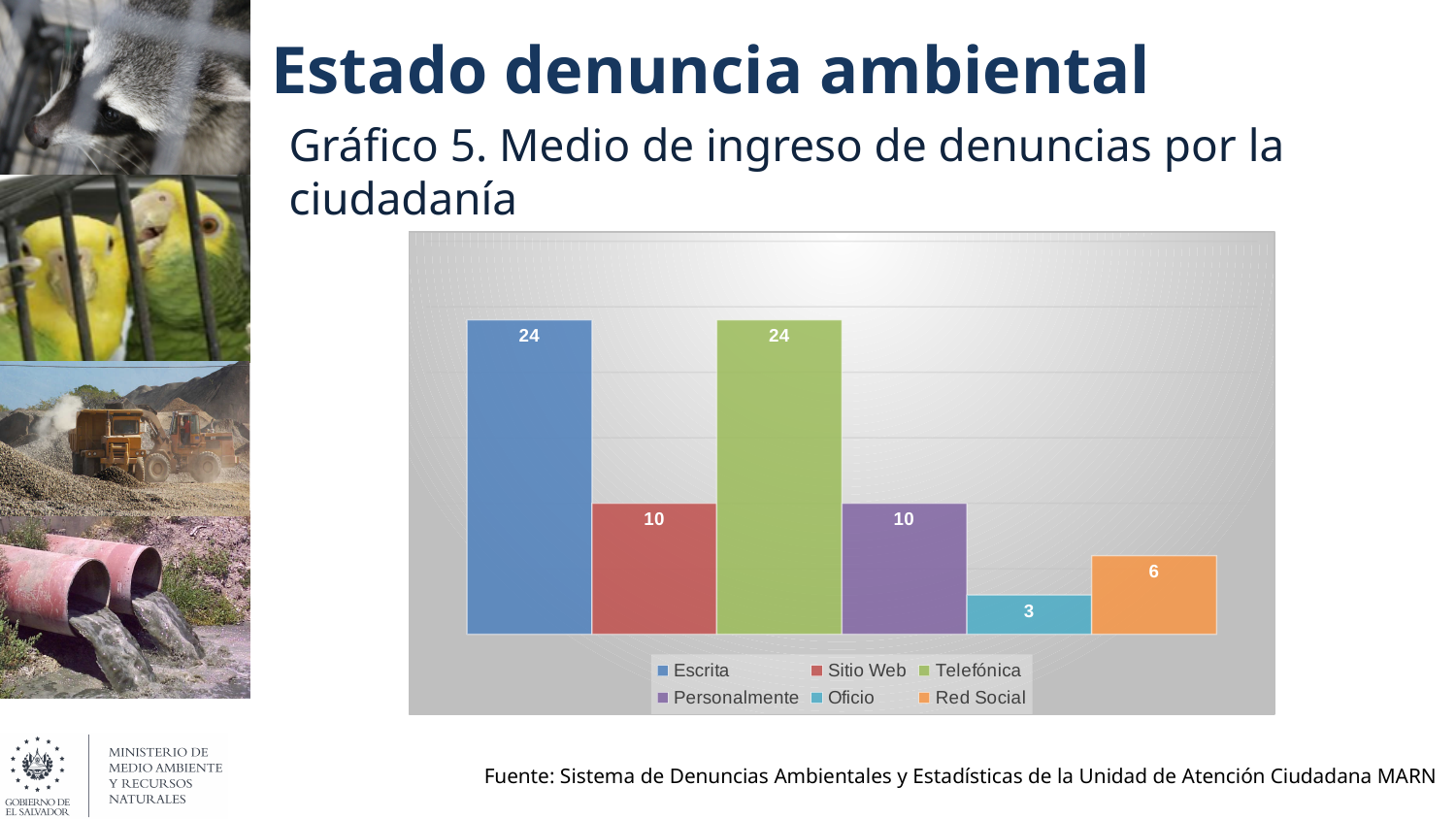
What is the difference between the values for Red Social and Oficio? 3 Which is larger, the value for Escrita or the value for Personalmente? Escrita What is the difference between the values for Telefónica and Personalmente? 14 What kind of chart is shown on the slide? Bar chart How many series does the legend list? 6 What colour is the bar for Telefónica? Green Which category has the lowest value? Oficio What is the value for Oficio? 3 What is the value for Red Social? 6 Which is larger, the value for Sitio Web or the value for Red Social? Sitio Web What is the value for Sitio Web? 10 What is the value for Escrita? 24